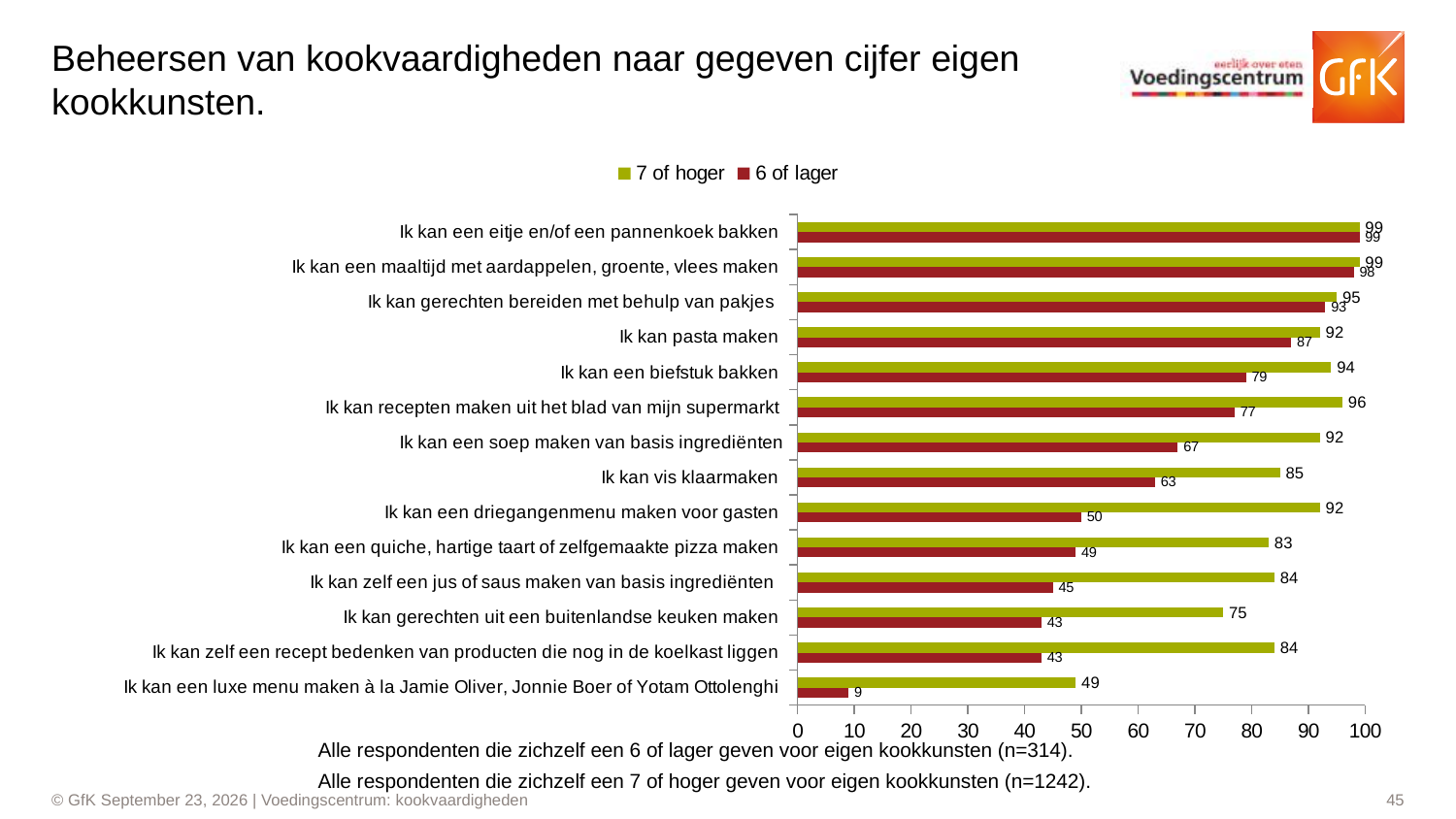
What is the difference between the "7 of hoger" and "6 of lager" values for "Ik kan gerechten uit een buitenlandse keuken maken"? 32 What is the difference between the "7 of hoger" and "6 of lager" values for "Ik kan een driegangenmenu maken voor gasten"? 42 Which is larger: the "6 of lager" value for "Ik kan pasta maken" or the "6 of lager" value for "Ik kan een soep maken van basis ingrediënten"? Ik kan pasta maken How many categories are shown in the chart? 14 What value is shown for "7 of hoger" for "Ik kan een biefstuk bakken"? 94 What are the two series names listed in the legend? 7 of hoger; 6 of lager What kind of chart is shown on the slide? Bar chart Which category has the highest value for the "6 of lager" series? Ik kan een eitje en/of een pannenkoek bakken What value is shown for "6 of lager" for "Ik kan vis klaarmaken"? 63 How many series does the legend list? 2 What value is shown for "6 of lager" for "Ik kan een luxe menu maken à la Jamie Oliver, Jonnie Boer of Yotam Ottolenghi"? 9 Which category has the lowest value for the "7 of hoger" series? Ik kan een luxe menu maken à la Jamie Oliver, Jonnie Boer of Yotam Ottolenghi